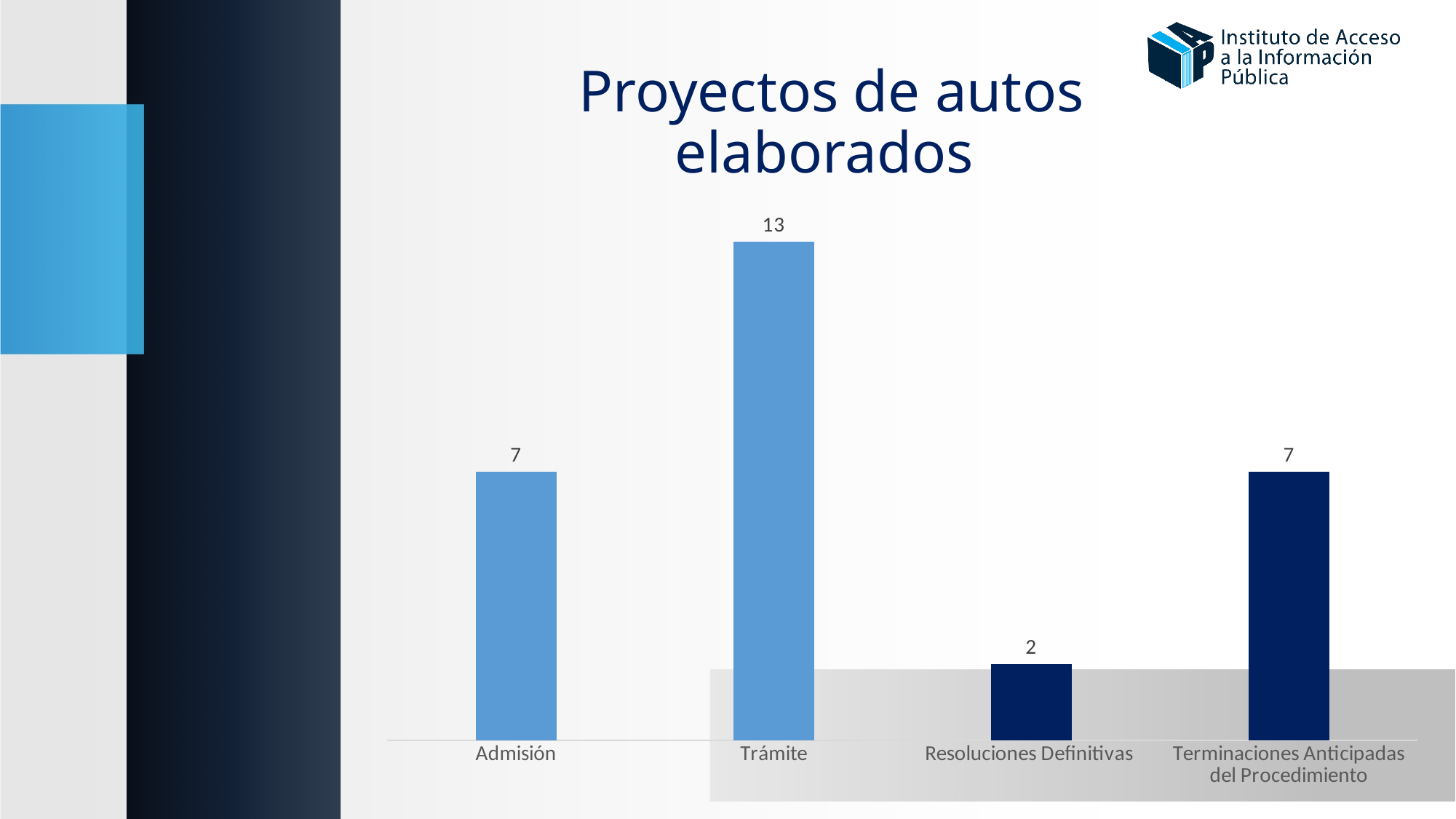
How many categories are shown in the chart? 4 What is the value for Admisión? 7 What is the value for Terminaciones Anticipadas del Procedimiento? 7 Which category has the lowest value? Resoluciones Definitivas What is the title of the chart? Proyectos de autos elaborados What is the difference between the values for Trámite and Admisión? 6 What is the value for Resoluciones Definitivas? 2 Which is larger, the value for Trámite or the value for Resoluciones Definitivas? Trámite What kind of chart is shown on the slide? Bar chart What is the difference between the values for Terminaciones Anticipadas del Procedimiento and Resoluciones Definitivas? 5 Which category has the highest value? Trámite What is the value for Trámite? 13